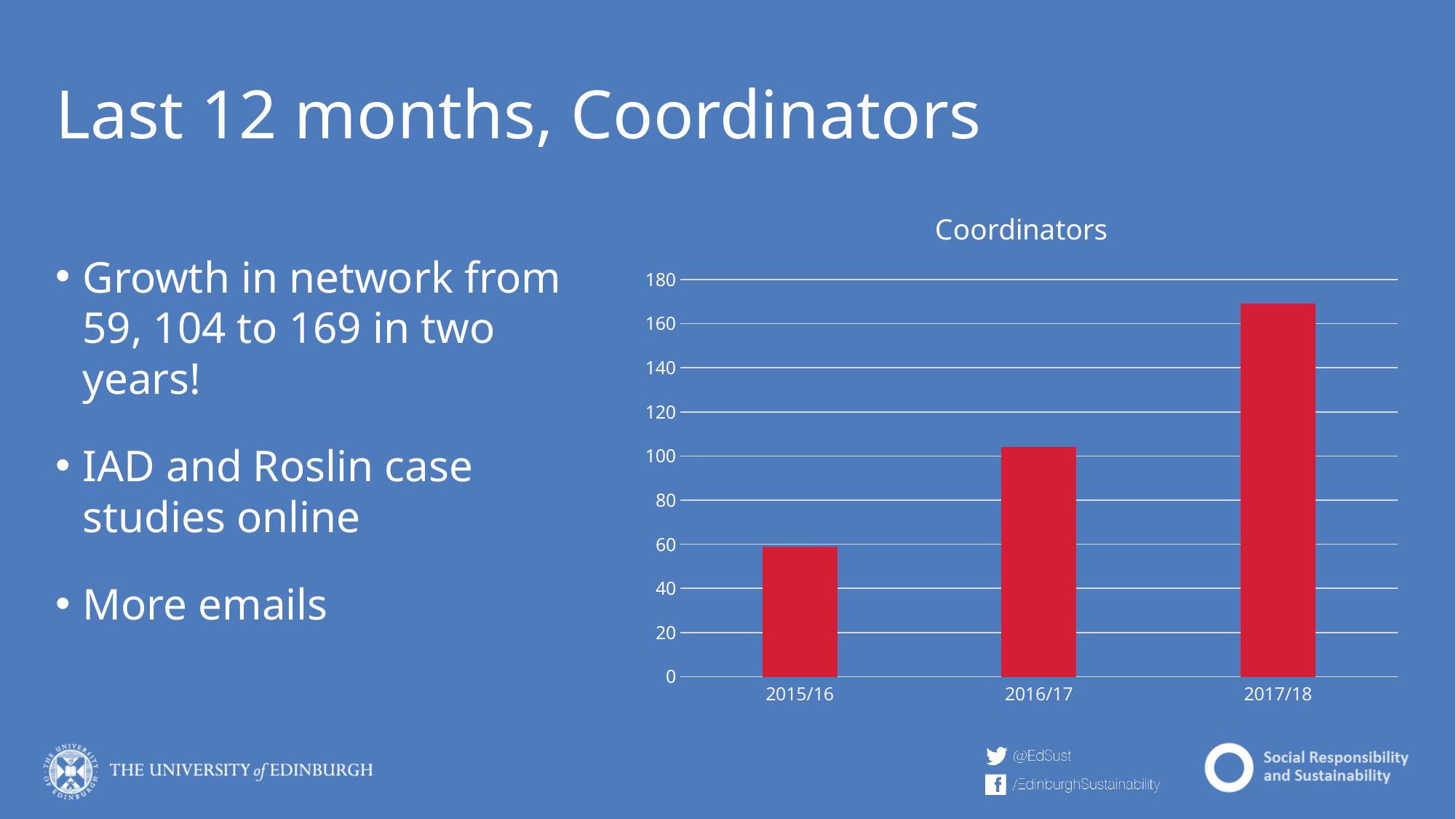
Is the value for 2015/16 greater or less than 60? less How many bars are plotted in the Coordinators chart? 3 Which is larger, the value for 2016/17 or the value for 2015/16? 2016/17 Do the values rise or fall from 2015/16 to 2017/18? rise Which year has the lowest value in the Coordinators chart? 2015/16 Is the value for 2017/18 greater or less than 180? less What is the highest value shown on the vertical axis of the chart? 180 Which year has the highest value in the Coordinators chart? 2017/18 What kind of chart is shown on the slide? bar chart Is the value for 2017/18 greater or less than 160? greater What is the title of the chart? Coordinators